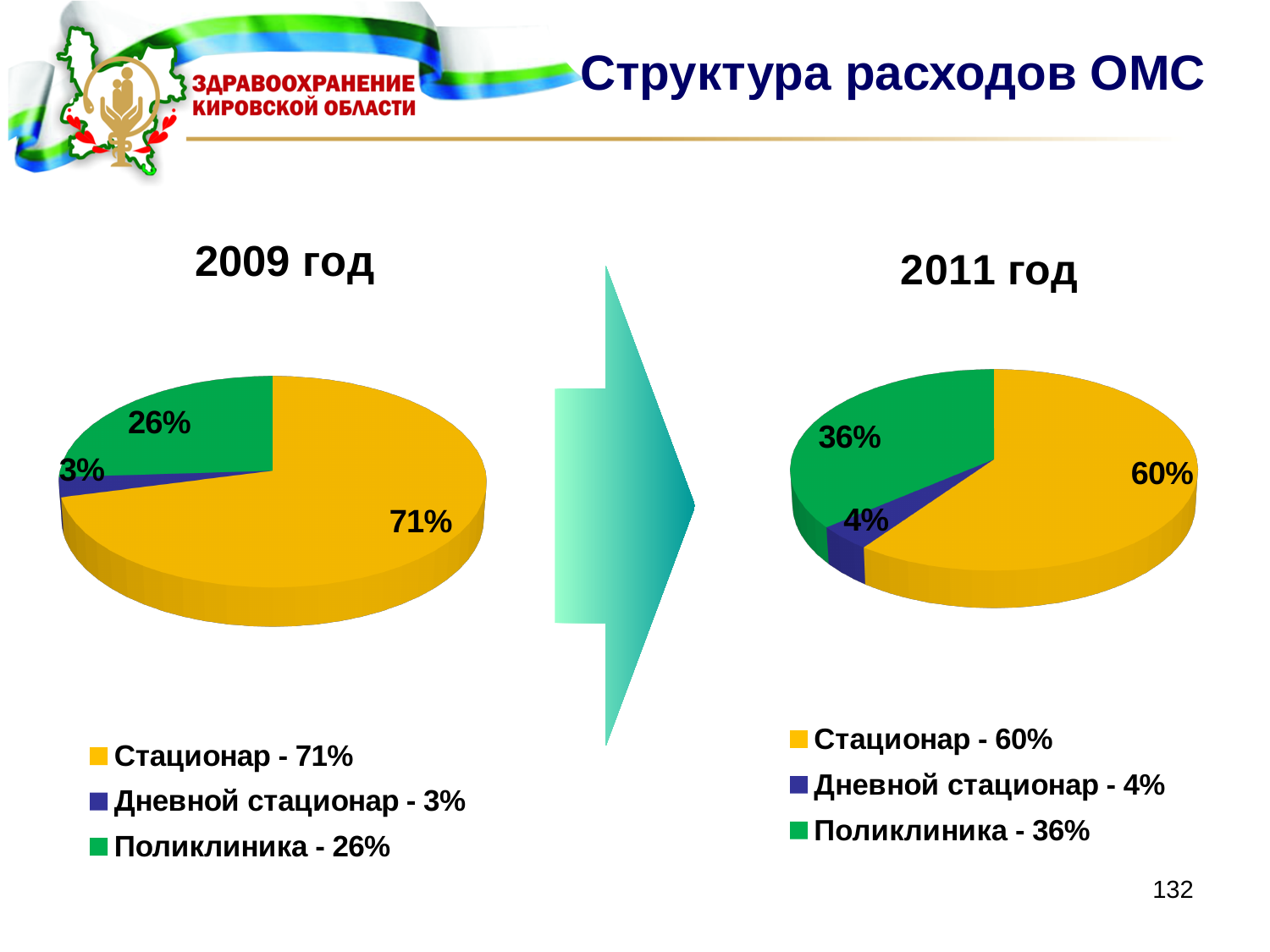
How many slices does the 2011 год pie chart have? 3 In the 2009 год pie chart, which category has the smallest share? Дневной стационар What type of chart is used for 2009 год? Pie chart In the 2009 год pie chart, what share does Стационар have? 71% In the 2009 год pie chart, what share does Дневной стационар have? 3% What is the title of the slide containing the two pie charts? Структура расходов ОМС What is the difference between the Стационар share in 2009 год and in 2011 год? 11% In the 2011 год pie chart, what share does Поликлиника have? 36% Is the Поликлиника share larger in the 2009 год chart or the 2011 год chart? 2011 год What colour represents Поликлиника in the 2009 год chart legend? Green In the 2011 год pie chart, what is the combined share of Дневной стационар and Поликлиника? 40% In the 2011 год pie chart, which category has the largest share? Стационар